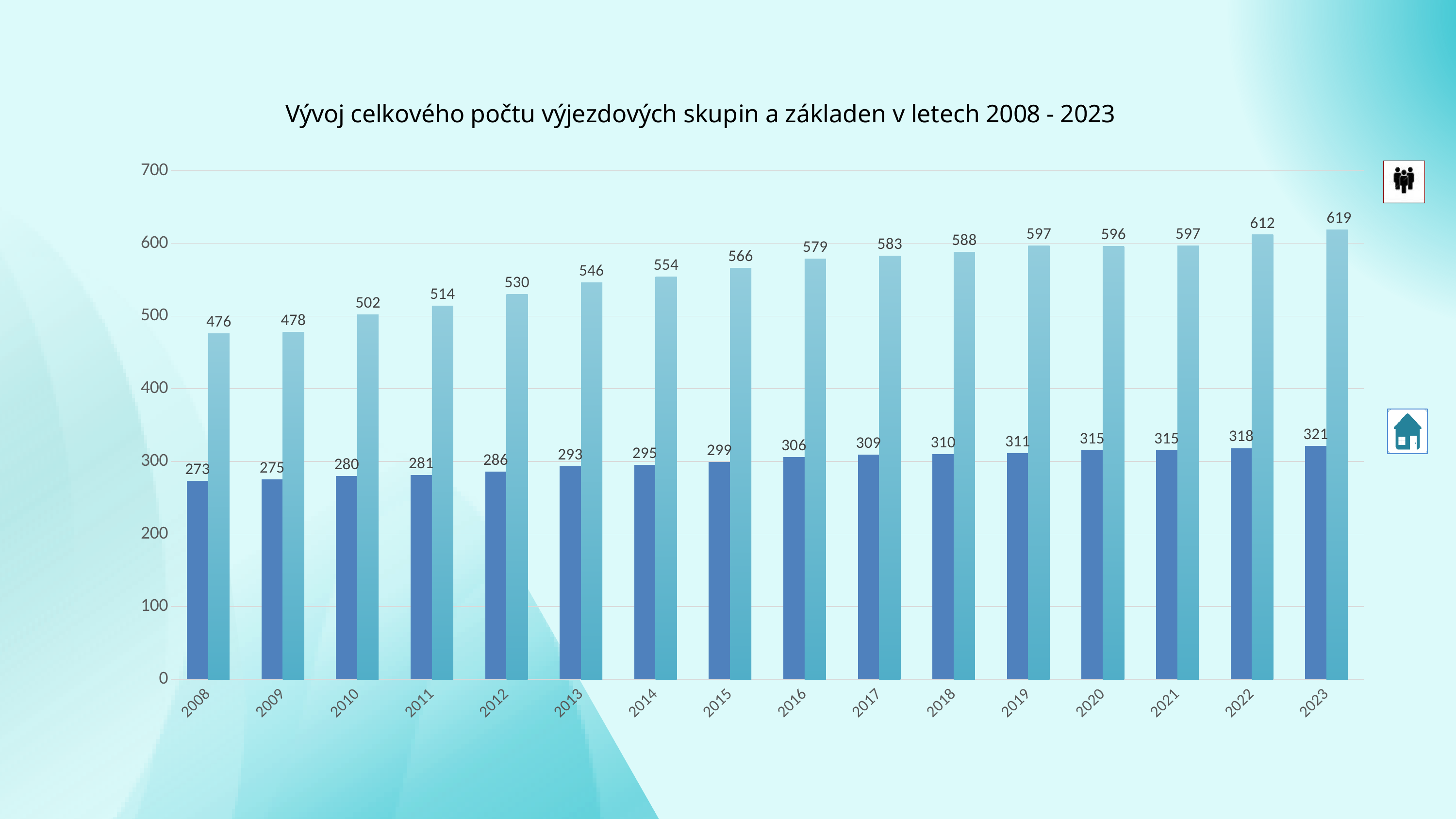
What kind of chart is shown on the slide? Bar chart In which year is the dark blue bar lowest? 2008 What is the difference between the light blue bar values for 2023 and 2008? 143 What is the value of the dark blue bar for 2008? 273 How many years are shown on the x axis? 16 What is the value of the dark blue bar for 2019? 311 What is the difference between the light blue and dark blue bar values for 2012? 244 What is the value of the light blue bar for 2023? 619 In which year is the light blue bar highest? 2023 Do the light blue bar values generally rise or fall from 2008 to 2023? Rise Which is larger, the light blue bar for 2010 or the light blue bar for 2011? 2011 What is the value of the light blue bar for 2014? 554